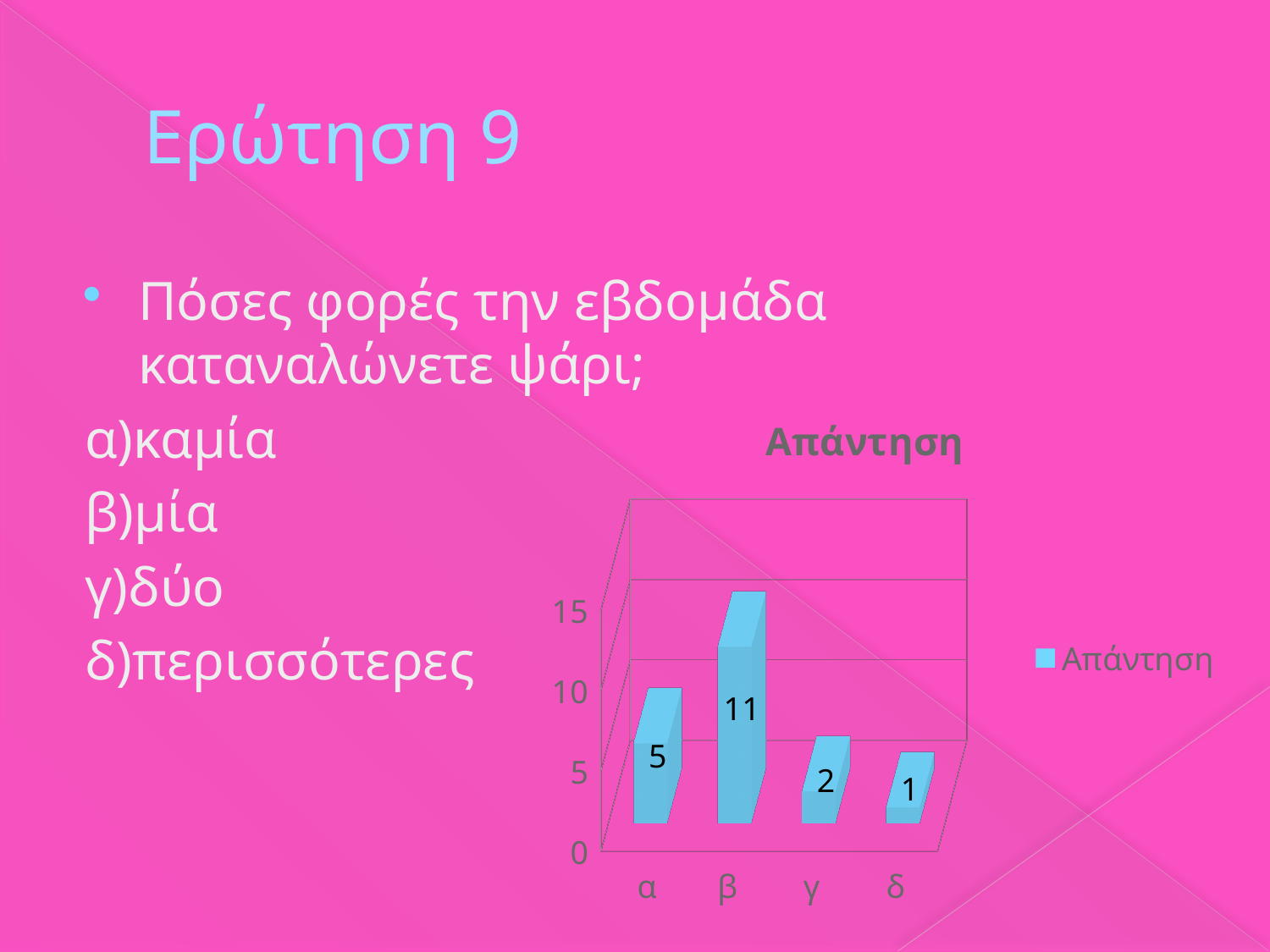
Which is larger, the value for γ or the value for δ? γ How many series does the legend list? 1 What is the title of the chart? Απάντηση What is the difference between the values for β and α? 6 What is the value for category β? 11 Is the value for β greater or less than 10? greater Which category has the highest value? β What is the value for category δ? 1 What is the value for category α? 5 What kind of chart is shown? bar chart How many categories are shown on the x axis? 4 Which category has the lowest value? δ